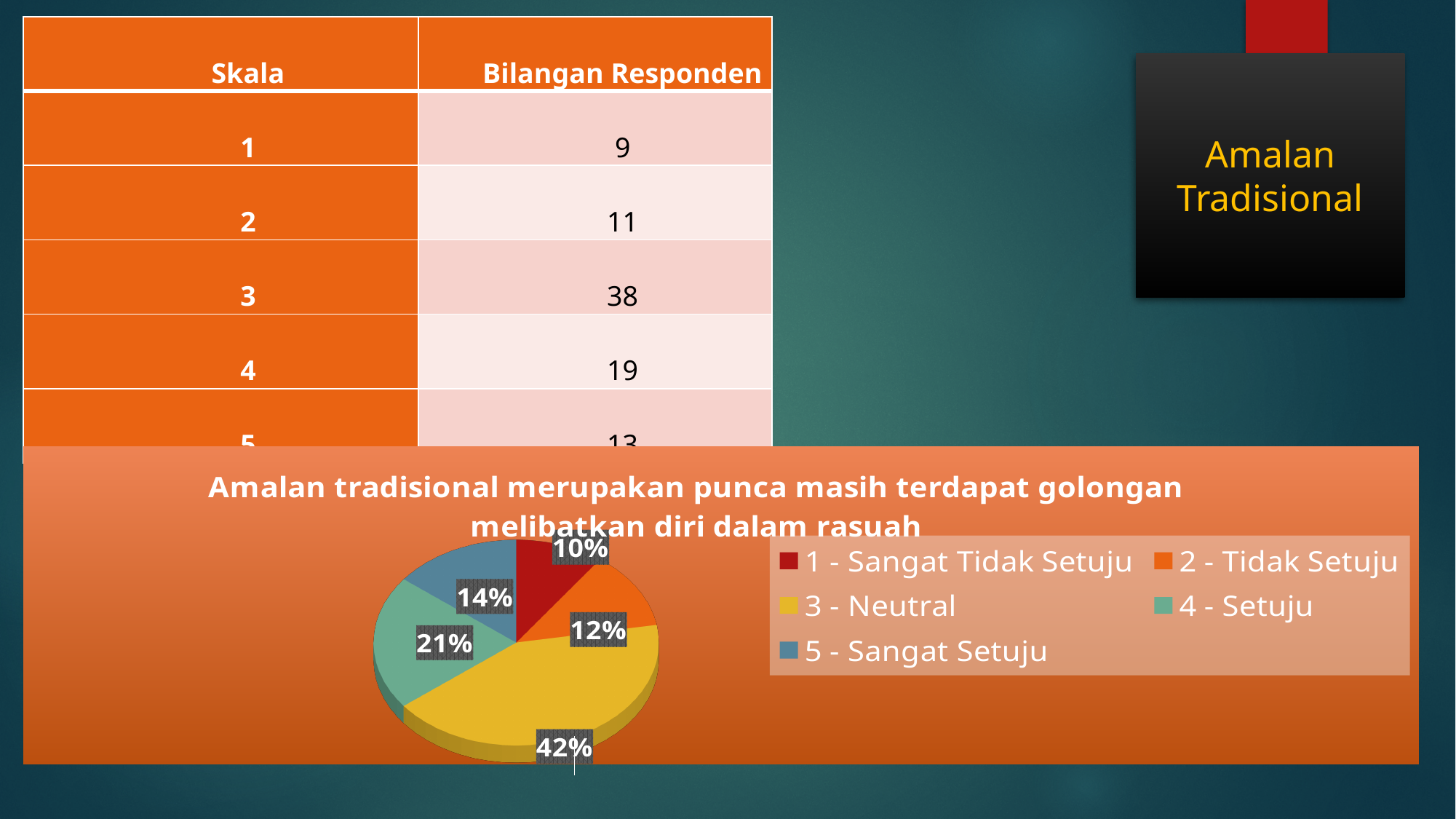
What share of the pie does "2 - Tidak Setuju" have? 12% What colour is the "3 - Neutral" slice in the pie chart? yellow What is the difference in percentage points between the "3 - Neutral" slice and the "4 - Setuju" slice? 21 Which slice is larger, "4 - Setuju" or "5 - Sangat Setuju"? 4 - Setuju What share of the pie does "3 - Neutral" have? 42% What kind of chart is shown on the slide? pie chart How many categories does the legend of the pie chart list? 5 Which category has the smallest slice of the pie? 1 - Sangat Tidak Setuju Which category has the largest slice of the pie? 3 - Neutral What share of the pie does "1 - Sangat Tidak Setuju" have? 10%